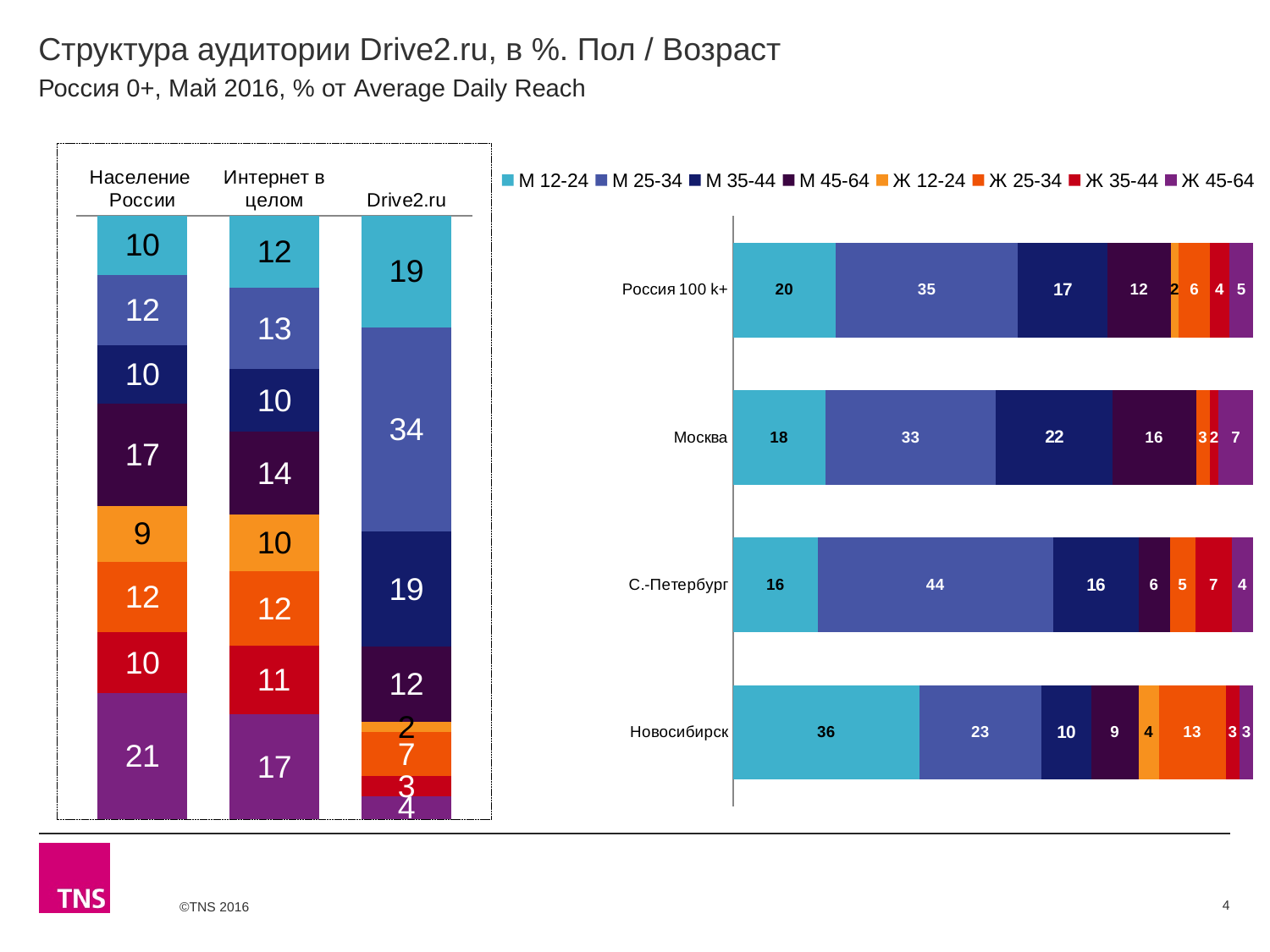
In the left chart, what is the total of the Drive2.ru stacked bar? 100 How many series does the legend of the right chart list? 8 In the right chart, which series has the largest segment in the Россия 100 k+ bar? М 25-34 How many categories (bars) are shown in the right chart? 4 In the left chart, what is the value for Ж 45-64 in the Население России bar? 21 In the right chart, what is the value for М 25-34 for С.-Петербург? 44 In the left chart, what is the value for М 25-34 in the Drive2.ru bar? 34 In the right chart, what is the value for М 12-24 for Новосибирск? 36 In the right chart, which has the larger М 35-44 value: Москва or Россия 100 k+? Москва In the left chart, what is the difference between the М 25-34 value for Drive2.ru and the М 25-34 value for Население России? 22 In the right chart, which series has the smallest segment in the Россия 100 k+ bar? Ж 12-24 What type of chart is the right chart? Stacked bar chart